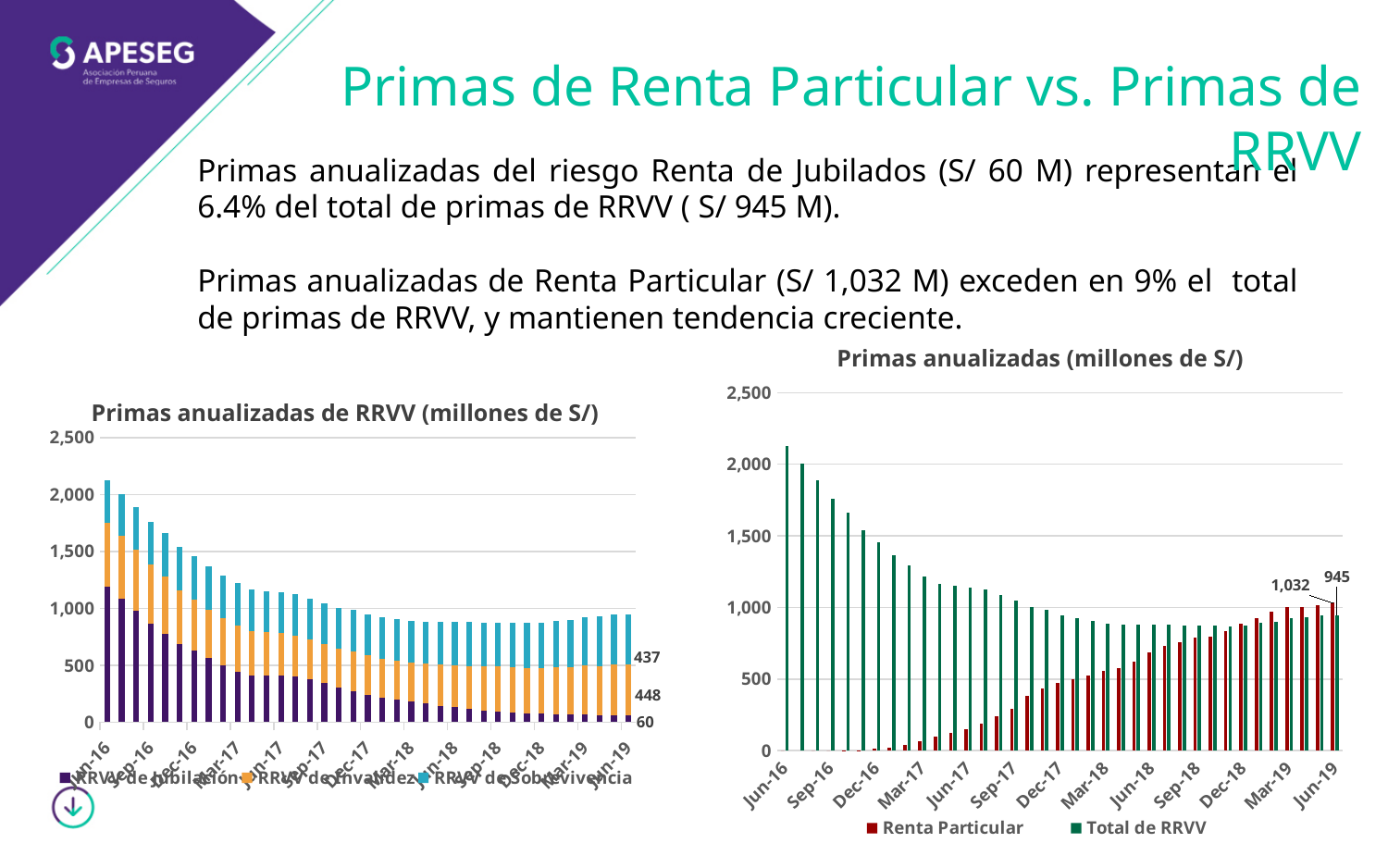
On the chart titled 'Primas anualizadas de RRVV (millones de S/)', what is the total of the stacked bar for Jun-19? 945 On the chart titled 'Primas anualizadas (millones de S/)', does Renta Particular rise or fall from Jun-16 to Jun-19? rise On the chart titled 'Primas anualizadas (millones de S/)', how many series does the legend list? 2 On the chart titled 'Primas anualizadas (millones de S/)', does Total de RRVV rise or fall from Jun-16 to Jun-19? fall On the chart titled 'Primas anualizadas de RRVV (millones de S/)', how many series does the legend list? 3 On the chart titled 'Primas anualizadas (millones de S/)', what is the value of Renta Particular for Jun-19? 1,032 On the chart titled 'Primas anualizadas de RRVV (millones de S/)', what is the value of RRVV de Sobrevivencia for Jun-19? 437 On the chart titled 'Primas anualizadas (millones de S/)', which is larger for Jun-19: Renta Particular or Total de RRVV? Renta Particular On the chart titled 'Primas anualizadas (millones de S/)', is the value of Total de RRVV for Jun-16 greater or less than 2,000? greater On the chart titled 'Primas anualizadas (millones de S/)', what is the difference between Renta Particular and Total de RRVV for Jun-19? 87 On the chart titled 'Primas anualizadas (millones de S/)', what is the value of Total de RRVV for Jun-19? 945 On the chart titled 'Primas anualizadas de RRVV (millones de S/)', what is the value of RRVV de Jubilación for Jun-19? 60